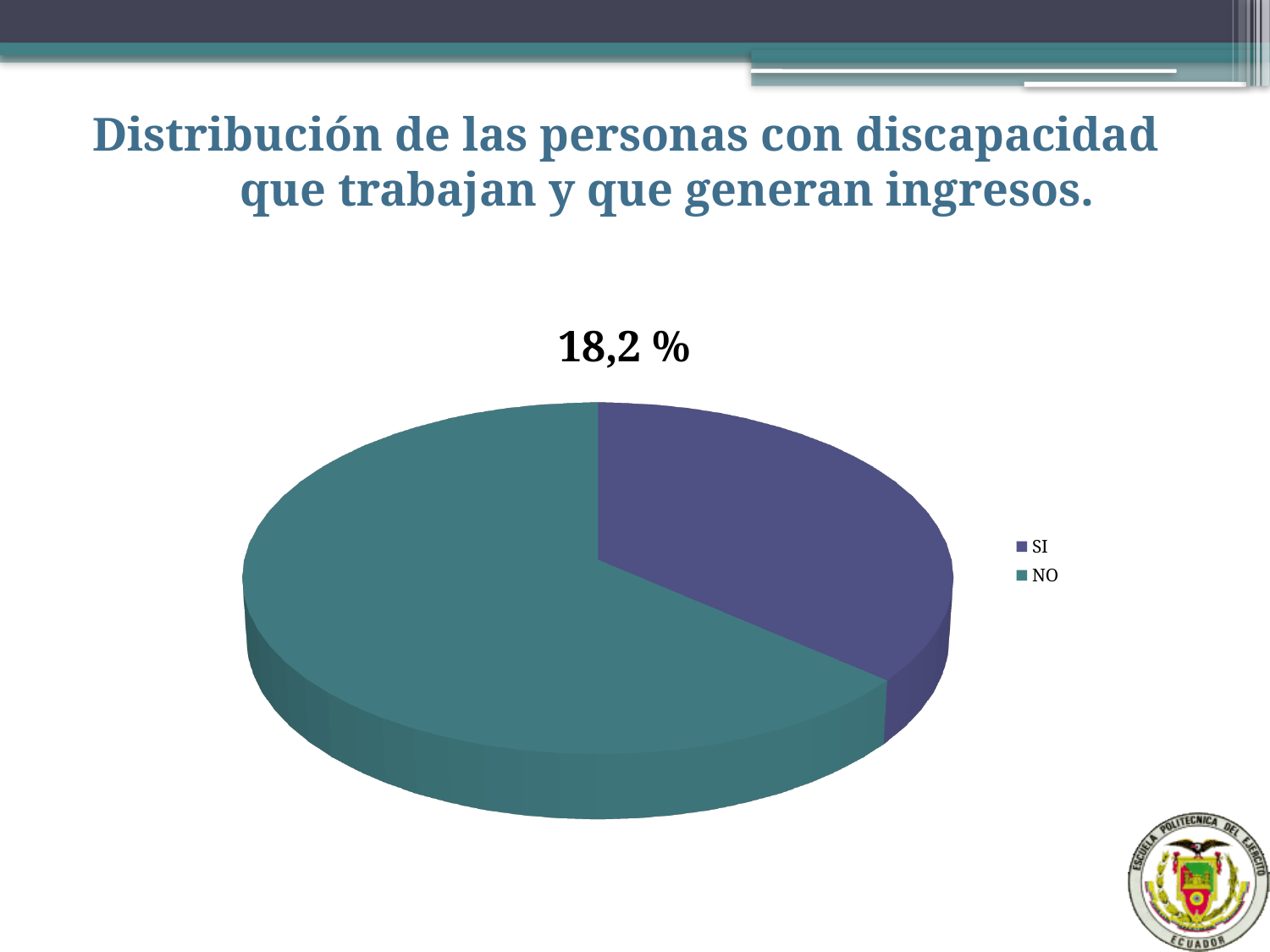
How many slices does the pie chart have? 2 What kind of chart is shown on the slide? Pie chart What text appears as the title directly above the pie chart? 18,2 % What are the two legend entries of the pie chart? SI and NO Is the share of the SI slice greater or less than 50%? less How many entries does the legend of the pie chart list? 2 Is the share of the NO slice greater or less than 50%? greater Which category has the smallest slice of the pie chart? SI Which slice is larger in the pie chart, SI or NO? NO Which category has the largest slice of the pie chart? NO